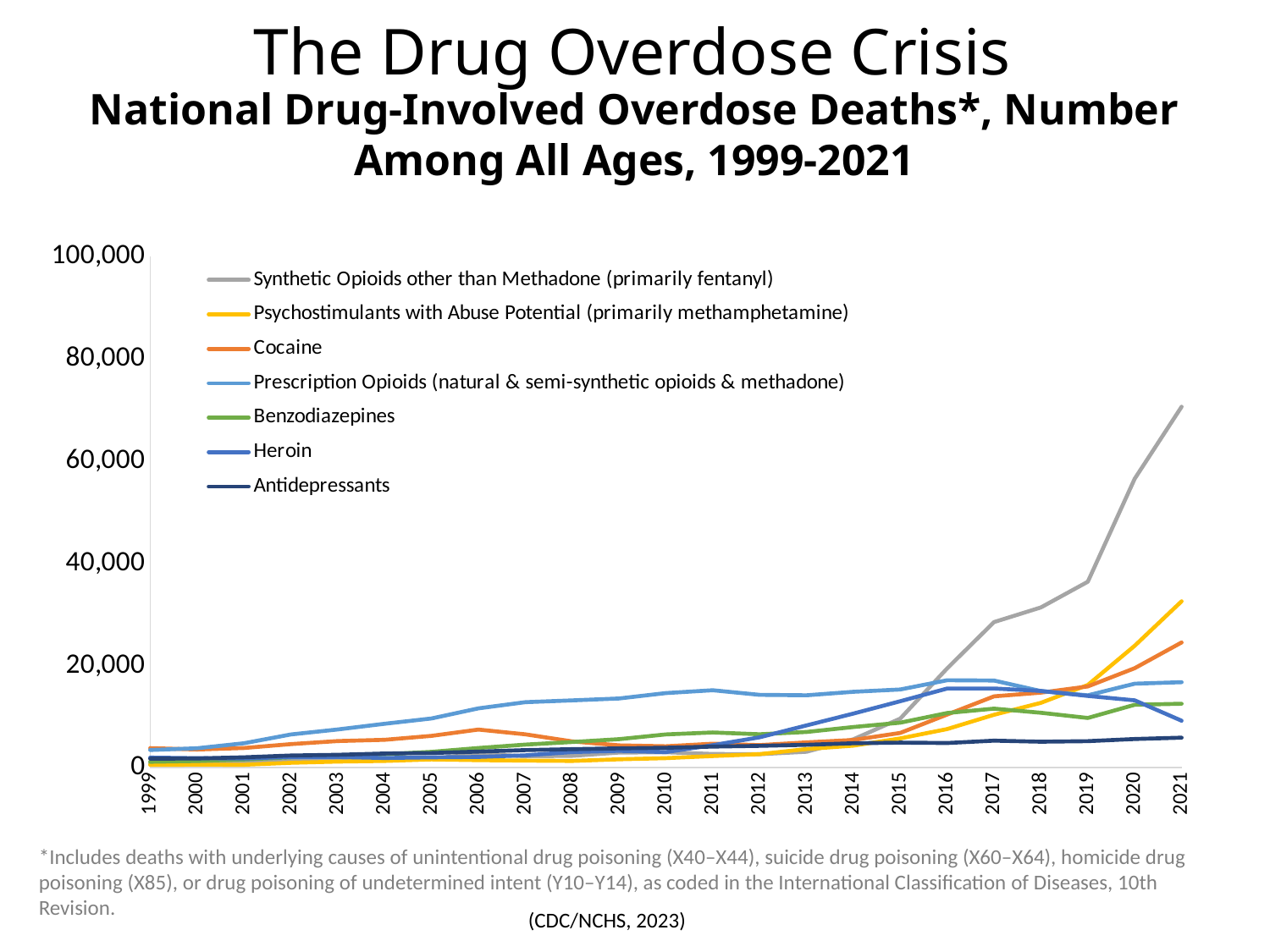
Is the 2021 value for Psychostimulants with Abuse Potential greater or less than 40,000? less Do the values for Heroin rise or fall from 2019 to 2021? fall In 2016, which is larger: Heroin or Cocaine? Heroin How many years are plotted along the x axis? 23 How many series does the legend list? 7 Which series has the highest value in 2021? Synthetic Opioids other than Methadone (primarily fentanyl) What kind of chart is shown on the slide? line chart Is the 2021 value for Synthetic Opioids other than Methadone greater or less than 60,000? greater In 2021, which is larger: Cocaine or Heroin? Cocaine Is the 2021 value for Prescription Opioids greater or less than 20,000? less Which series has the lowest value in 2021? Antidepressants Do the values for Synthetic Opioids other than Methadone rise or fall from 2013 to 2021? rise